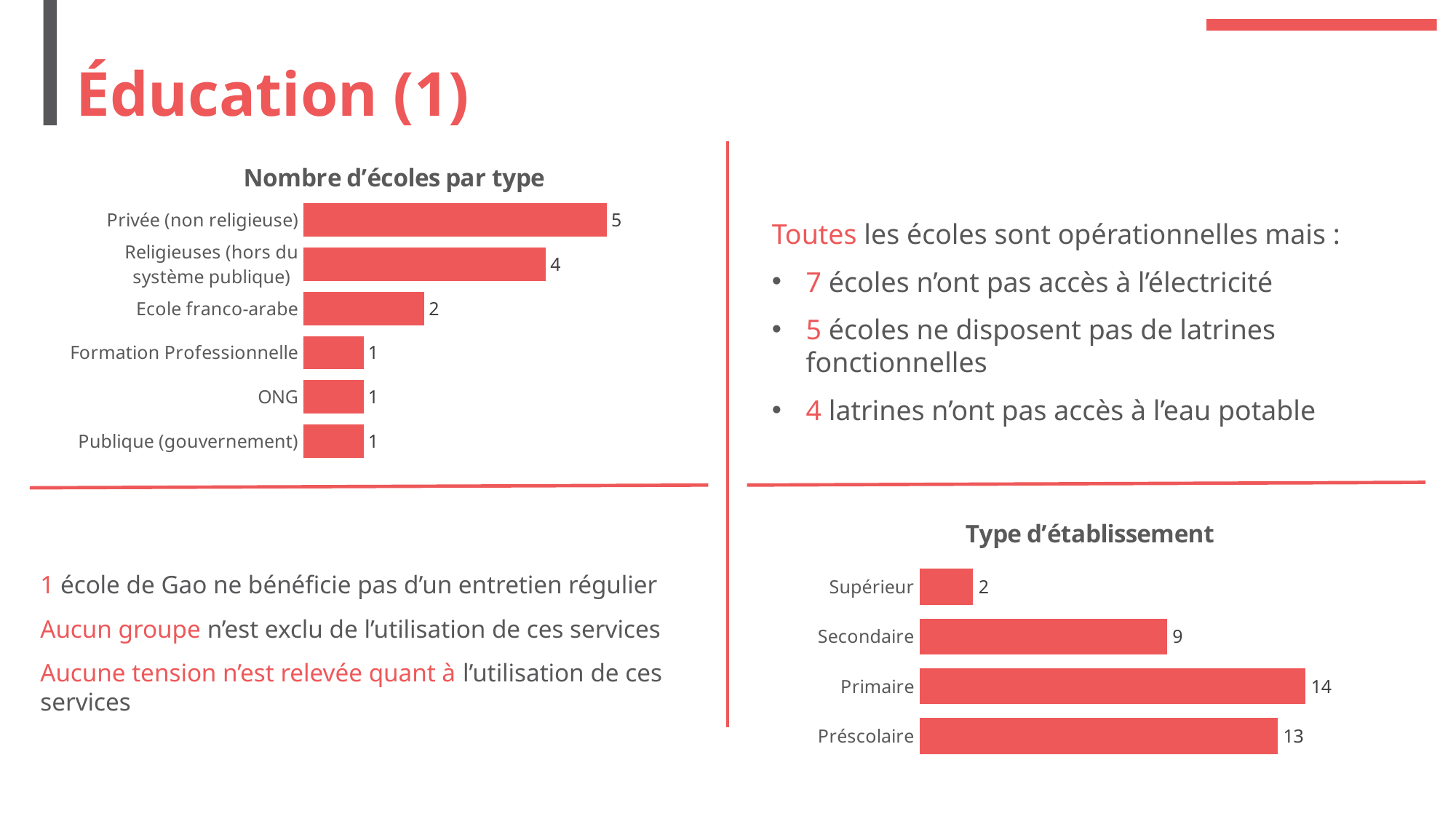
In the 'Type d'établissement' chart, how many categories are shown? 4 In the 'Nombre d'écoles par type' chart, what is the value for Ecole franco-arabe? 2 What kind of chart is 'Nombre d'écoles par type'? Bar chart In the 'Type d'établissement' chart, what is the difference between Primaire and Préscolaire? 1 In the 'Nombre d'écoles par type' chart, how many categories are shown? 6 In the 'Type d'établissement' chart, which is larger, Primaire or Secondaire? Primaire In the 'Type d'établissement' chart, which category has the lowest value? Supérieur In the 'Type d'établissement' chart, what is the value for Secondaire? 9 In the 'Nombre d'écoles par type' chart, what is the difference between Privée (non religieuse) and Religieuses (hors du système publique)? 1 In the 'Nombre d'écoles par type' chart, what is the value for Privée (non religieuse)? 5 In the 'Nombre d'écoles par type' chart, which category has the highest value? Privée (non religieuse) In the 'Type d'établissement' chart, what is the value for Préscolaire? 13